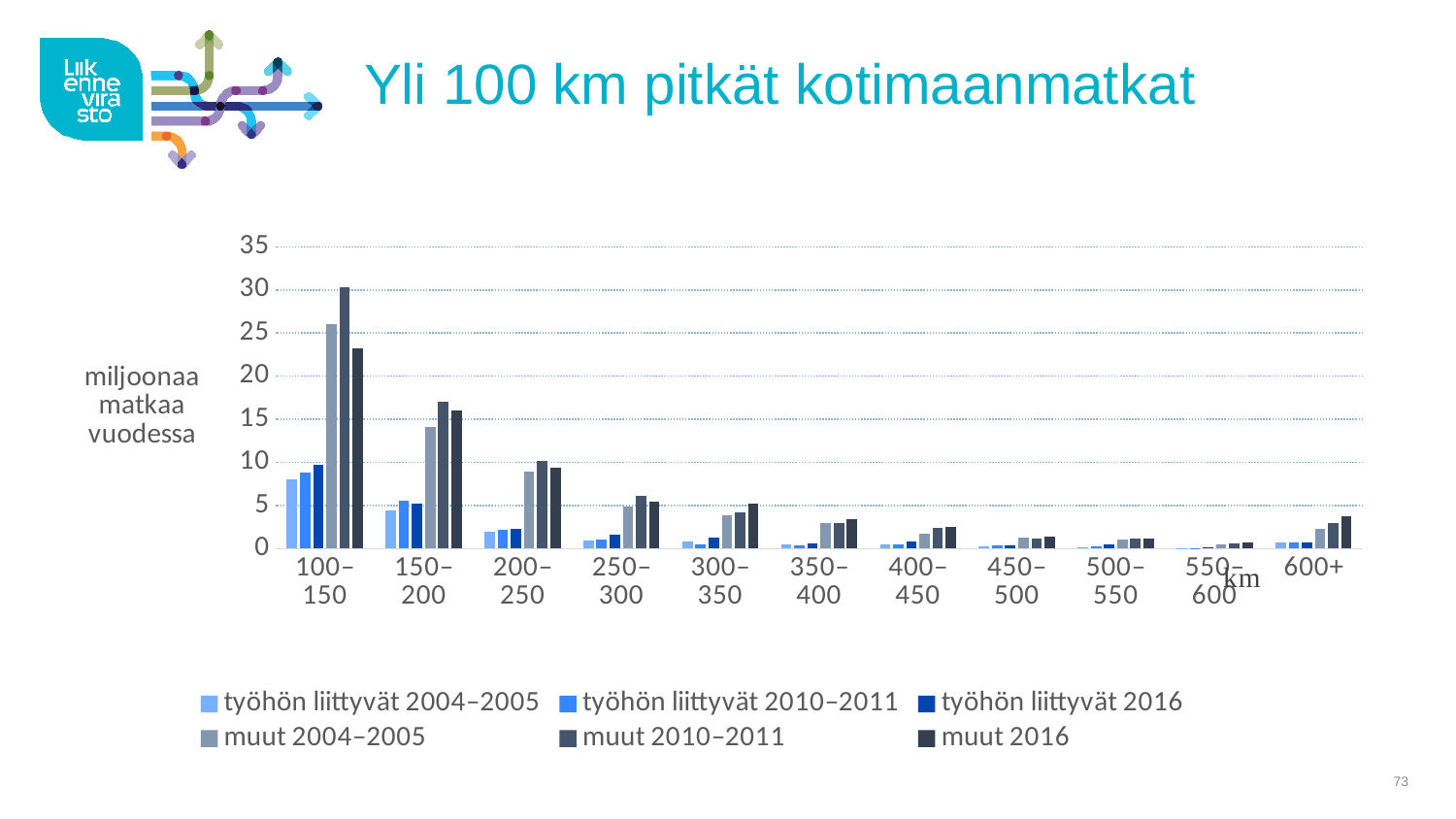
What is the title of the chart? Yli 100 km pitkät kotimaanmatkat Is the value for muut 2016 in the 100–150 km category greater or less than 25? less Which distance category has the lowest value for muut 2010–2011? 550–600 Is the value for muut 2010–2011 in the 150–200 km category greater or less than 15? greater Is the value for työhön liittyvät 2004–2005 in the 100–150 km category greater or less than 10? less How many distance categories are shown on the x axis? 11 What kind of chart is shown on the slide? bar chart Do the values for muut 2010–2011 generally rise or fall as the distance category increases from 100–150 to 550–600? fall How many series does the legend list? 6 Which distance category has the highest value for muut 2010–2011? 100–150 In the 100–150 km category, which is larger: muut 2010–2011 or muut 2016? muut 2010–2011